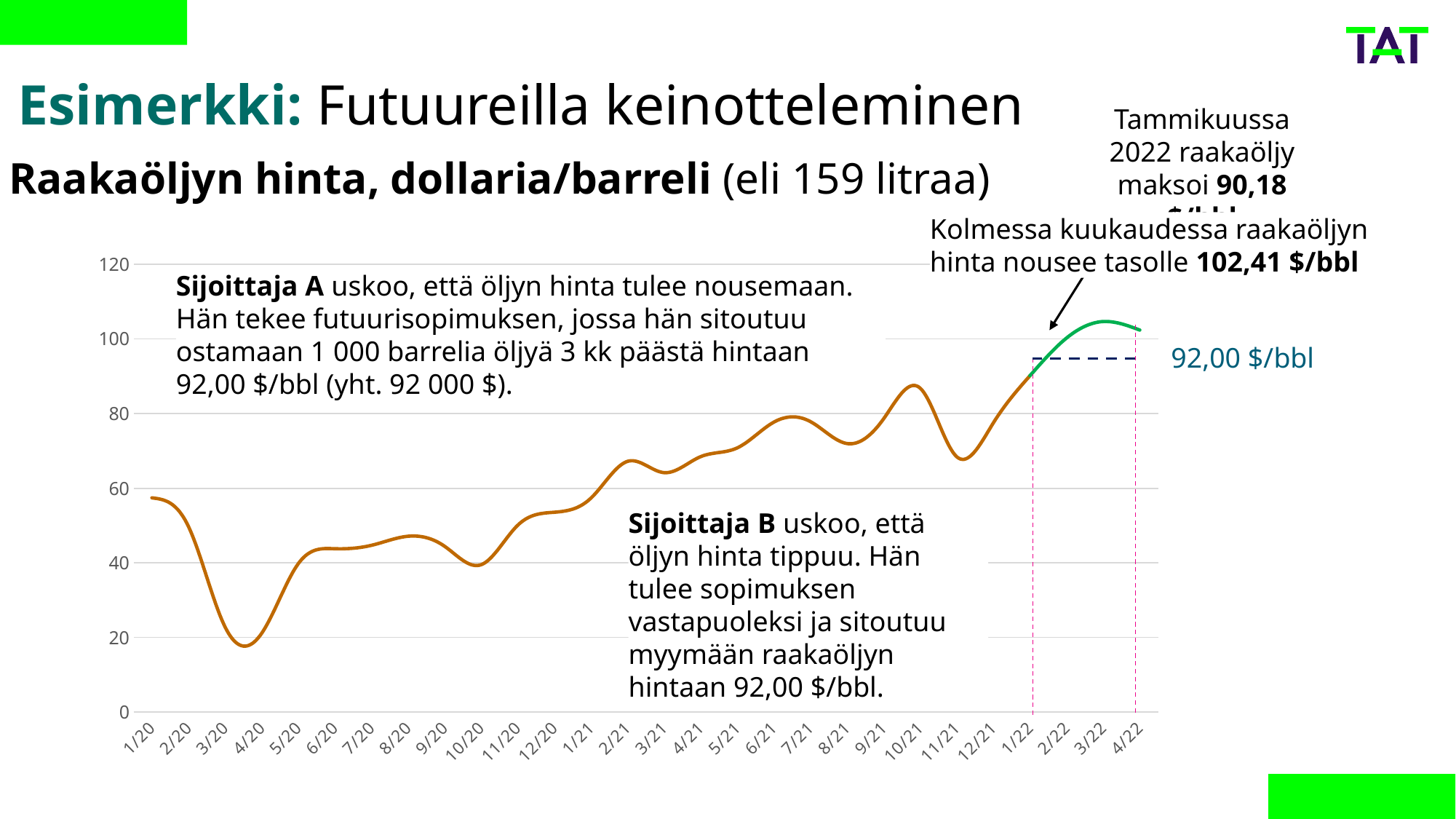
Is the value for 4/20 greater or less than 40? less What is the difference between the price after three months (102,41 $/bbl) and the futures price of 92,00 $/bbl? 10,41 $/bbl What is the title of the chart? Raakaöljyn hinta, dollaria/barreli Is the value for 3/22 greater or less than 100? greater How many month labels are shown on the x axis? 28 Is the value for 10/21 greater or less than 80? greater According to the annotation, what was the price of crude oil in January 2022? 90,18 $/bbl What price level is marked by the dashed horizontal line on the chart? 92,00 $/bbl According to the annotation, what level does the crude oil price rise to in three months? 102,41 $/bbl Overall, does the crude oil price rise or fall from 1/20 to 4/22? rise What kind of chart is shown on the slide? line chart Which is higher, the value for 10/21 or the value for 11/21? 10/21